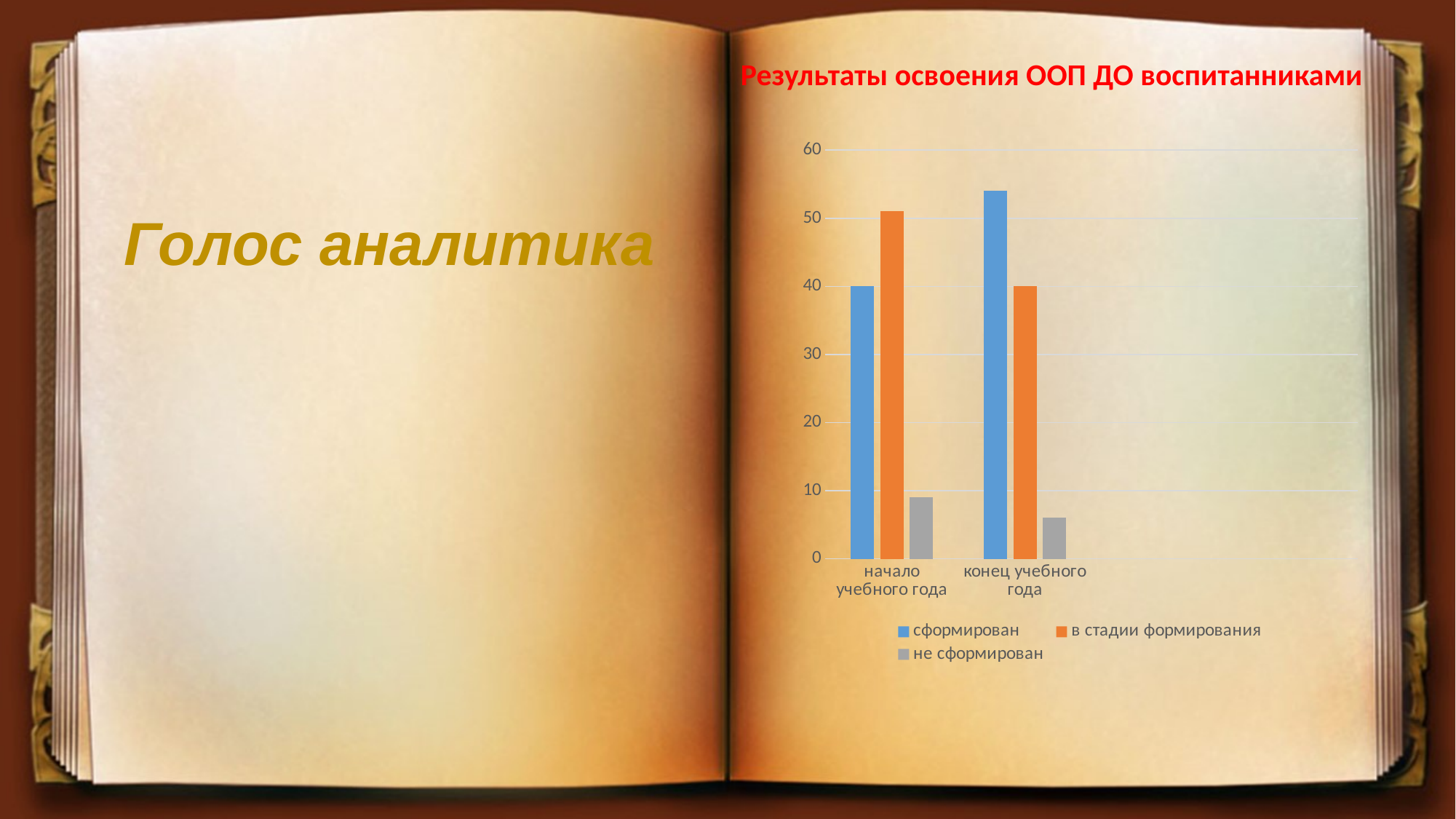
How many categories are shown on the x axis of the chart? 2 What is the value for 'в стадии формирования' at 'конец учебного года'? 40 What kind of chart is shown on the slide? bar chart Is the value for 'сформирован' at 'конец учебного года' greater or less than 50? greater Which series has the lowest value at 'начало учебного года'? не сформирован Is the value for 'в стадии формирования' at 'начало учебного года' greater or less than 40? greater Is the value for 'не сформирован' at 'начало учебного года' greater or less than 20? less Which series has the highest value at 'конец учебного года'? сформирован What is the value for 'сформирован' at 'начало учебного года'? 40 How many series does the legend of the chart list? 3 What is the title of the chart? Результаты освоения ООП ДО воспитанниками